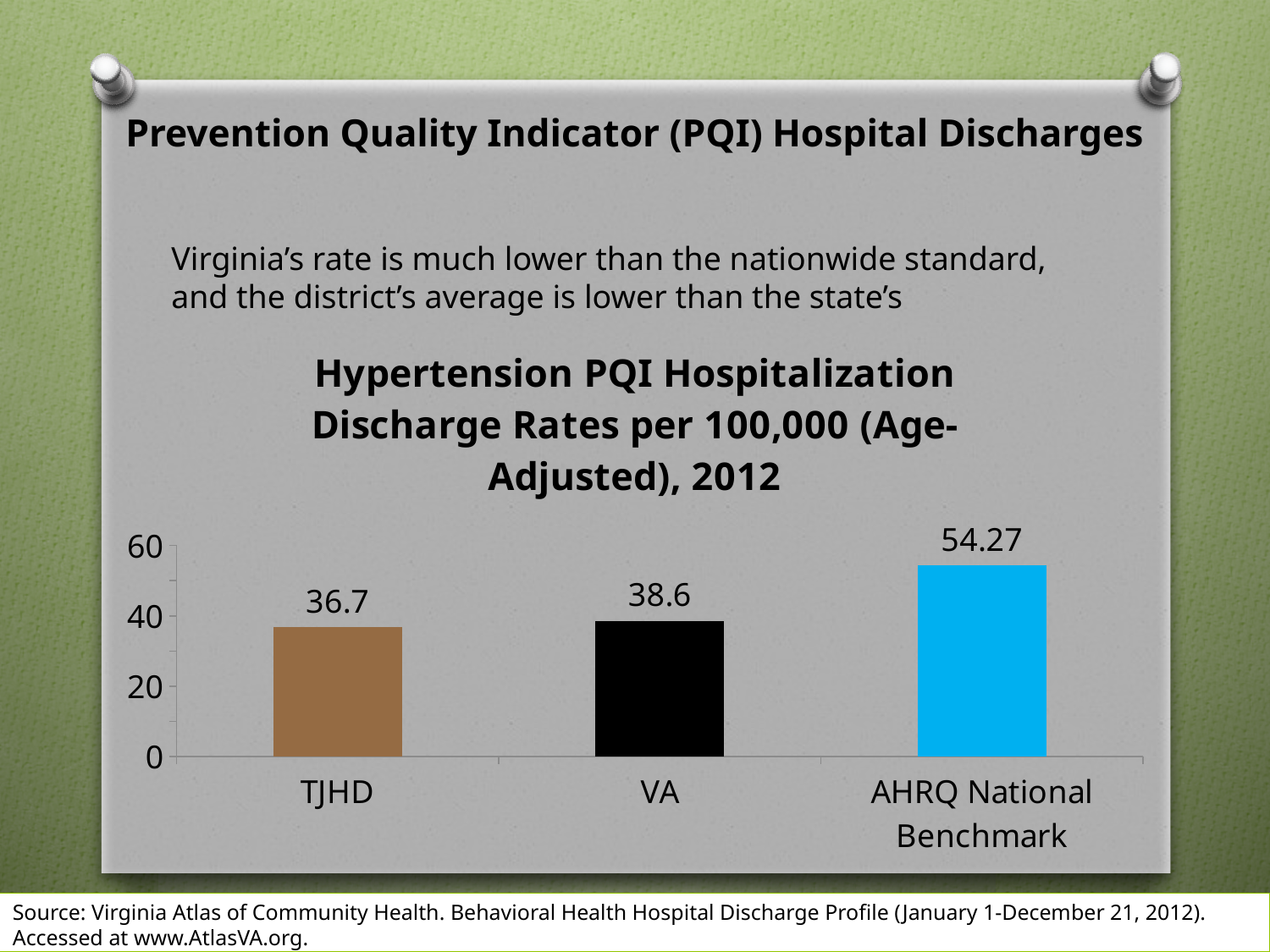
How many categories are shown on the chart? 3 Which category has the highest value? AHRQ National Benchmark What is the title of the chart? Hypertension PQI Hospitalization Discharge Rates per 100,000 (Age-Adjusted), 2012 What is the value for AHRQ National Benchmark? 54.27 Is the value for AHRQ National Benchmark greater or less than 40? greater What is the value for VA? 38.6 Which is larger, the value for VA or the value for AHRQ National Benchmark? AHRQ National Benchmark Which category has the lowest value? TJHD What is the value for TJHD? 36.7 What is the difference between the AHRQ National Benchmark value and the VA value? 15.67 What kind of chart is shown on the slide? bar chart What is the difference between the VA value and the TJHD value? 1.9